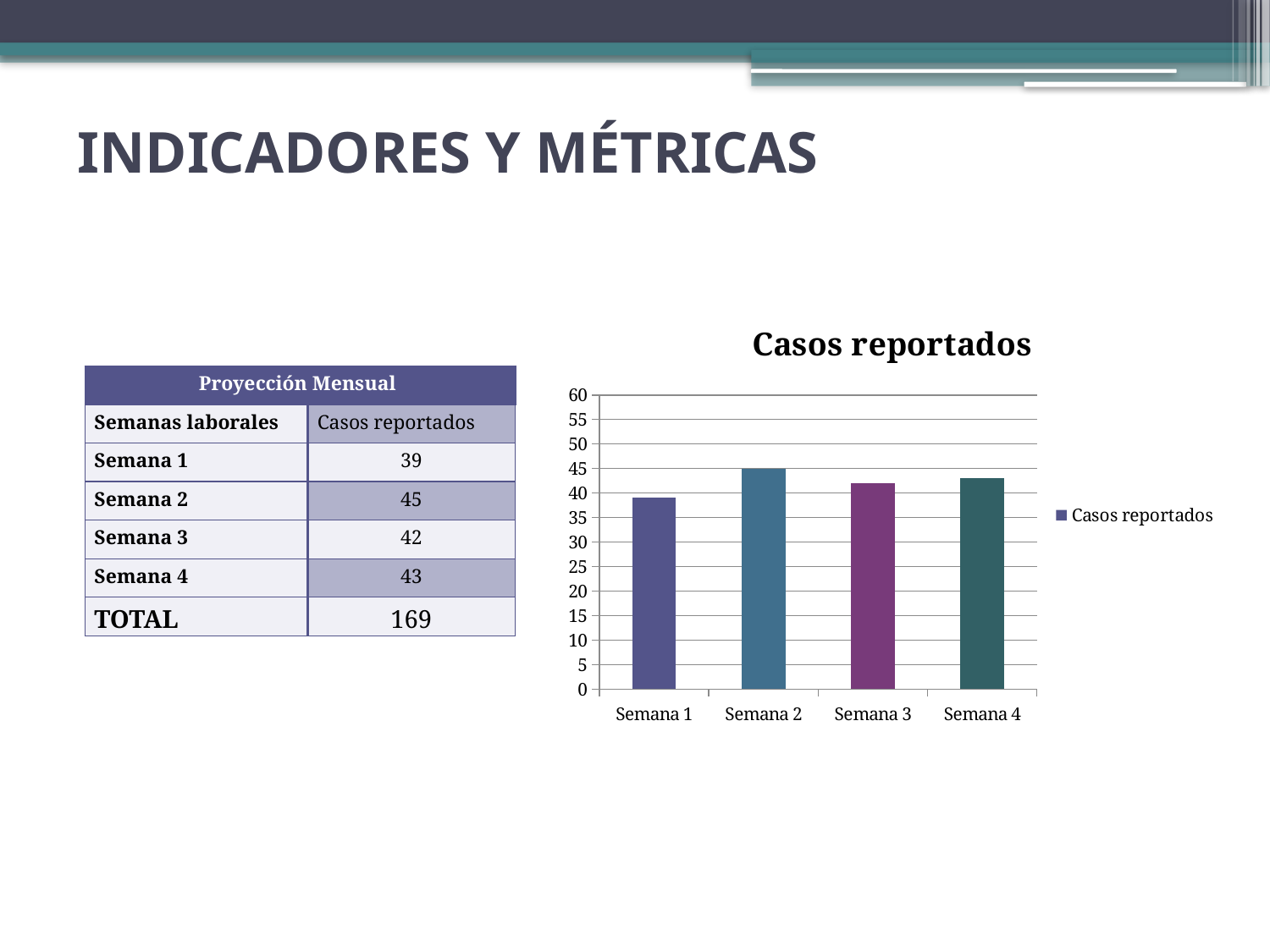
What is the title of the chart? Casos reportados Which week has the lowest number of Casos reportados? Semana 1 How many series does the chart legend list? 1 Is the value for Semana 1 greater or less than 40? less What type of chart is shown on the slide? bar chart How many categories are shown on the x axis of the chart? 4 What is the value of Casos reportados for Semana 4? 43 Which week has the highest number of Casos reportados? Semana 2 What is the value of Casos reportados for Semana 2? 45 Which has more Casos reportados, Semana 1 or Semana 2? Semana 2 What is the difference in Casos reportados between Semana 2 and Semana 1? 6 What is the value of Casos reportados for Semana 1? 39